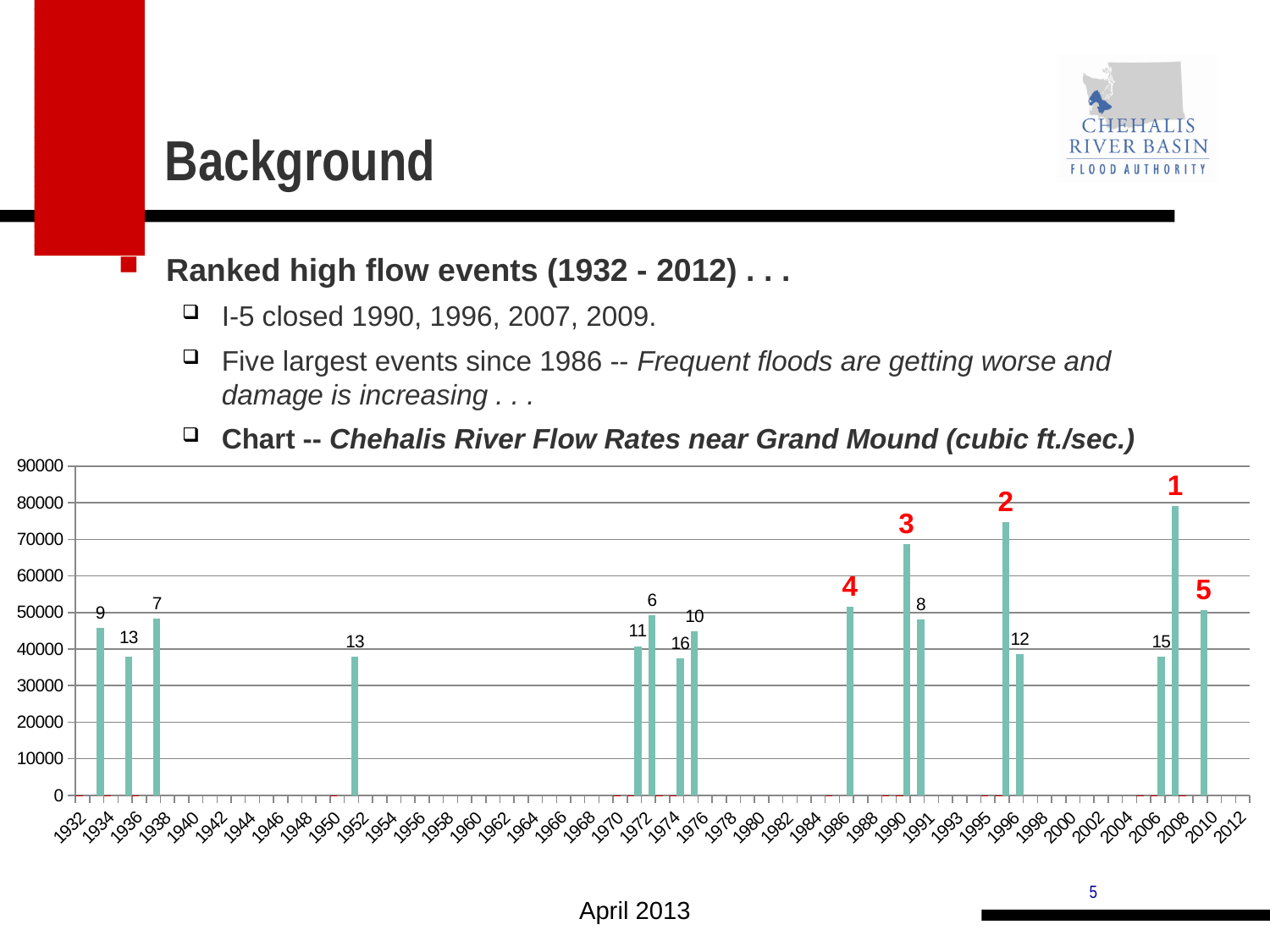
Which is larger, the bar labelled 1 or the bar labelled 2? the bar labelled 1 Is the value of the bar labelled 5 greater or less than 40000? greater Which is larger, the bar labelled 3 or the bar labelled 4? the bar labelled 3 Is the value of the bar labelled 1 greater or less than 70000? greater Is the value of the bar labelled 3 greater or less than 60000? greater What is the highest value shown on the chart's vertical axis? 90000 What is the title of the chart as given in the bullet text? Chehalis River Flow Rates near Grand Mound (cubic ft./sec.) What kind of chart is shown on the slide? bar chart Which rank label is shown above the tallest bar in the chart? 1